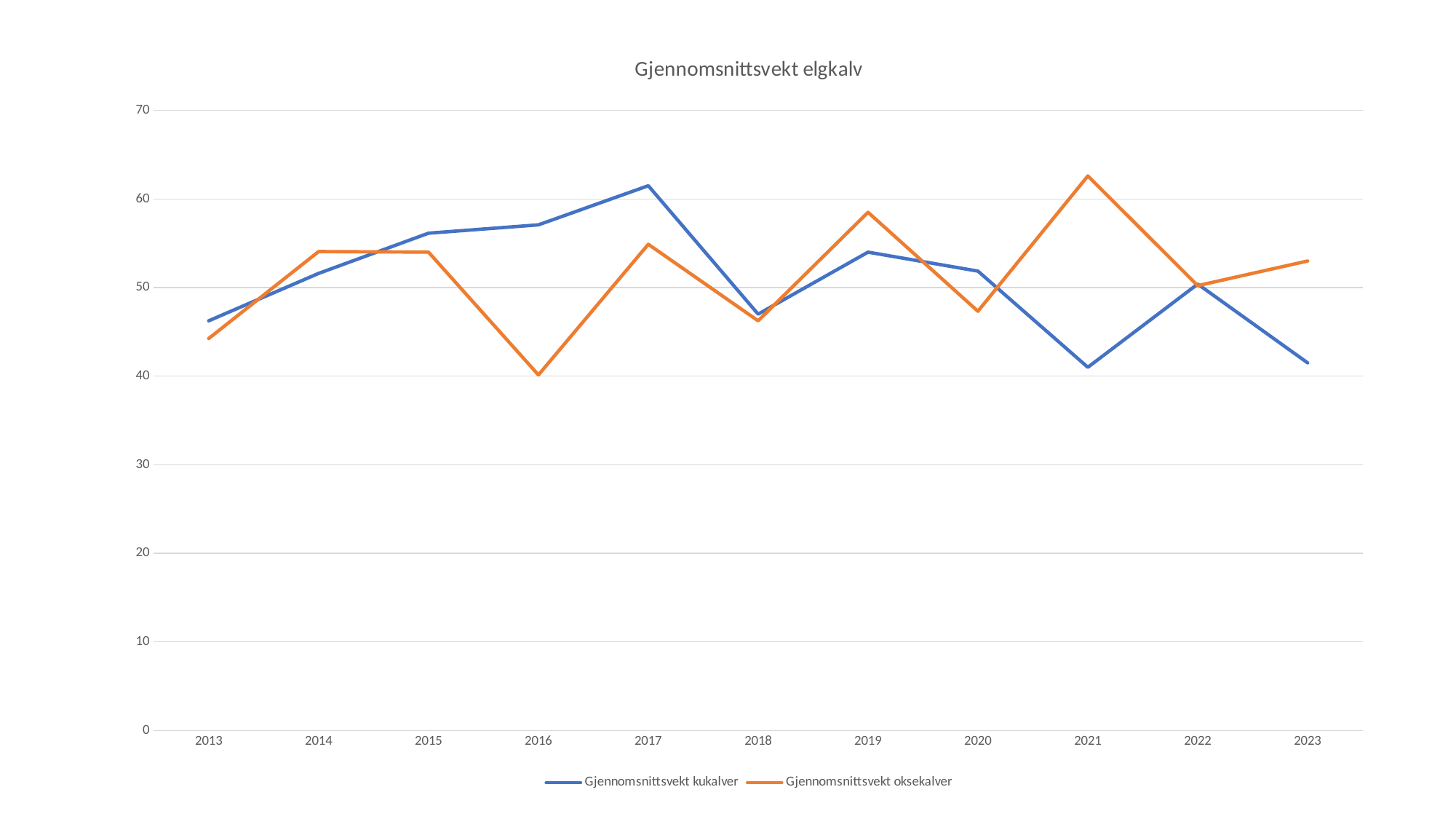
What is the title of the chart? Gjennomsnittsvekt elgkalv In which year is the value for Gjennomsnittsvekt kukalver highest? 2017 In which year is the value for Gjennomsnittsvekt oksekalver highest? 2021 Is the value for Gjennomsnittsvekt kukalver in 2017 greater or less than 60? greater How many years are shown on the x axis? 11 What type of chart is shown on the slide? Line chart Is the value for Gjennomsnittsvekt kukalver in 2021 greater or less than 50? less How many series does the legend list? 2 Is the value for Gjennomsnittsvekt oksekalver in 2016 greater or less than 50? less In which year is the value for Gjennomsnittsvekt oksekalver lowest? 2016 Does the value for Gjennomsnittsvekt kukalver rise or fall from 2013 to 2017? rise In 2016, which series has the larger value, Gjennomsnittsvekt kukalver or Gjennomsnittsvekt oksekalver? Gjennomsnittsvekt kukalver